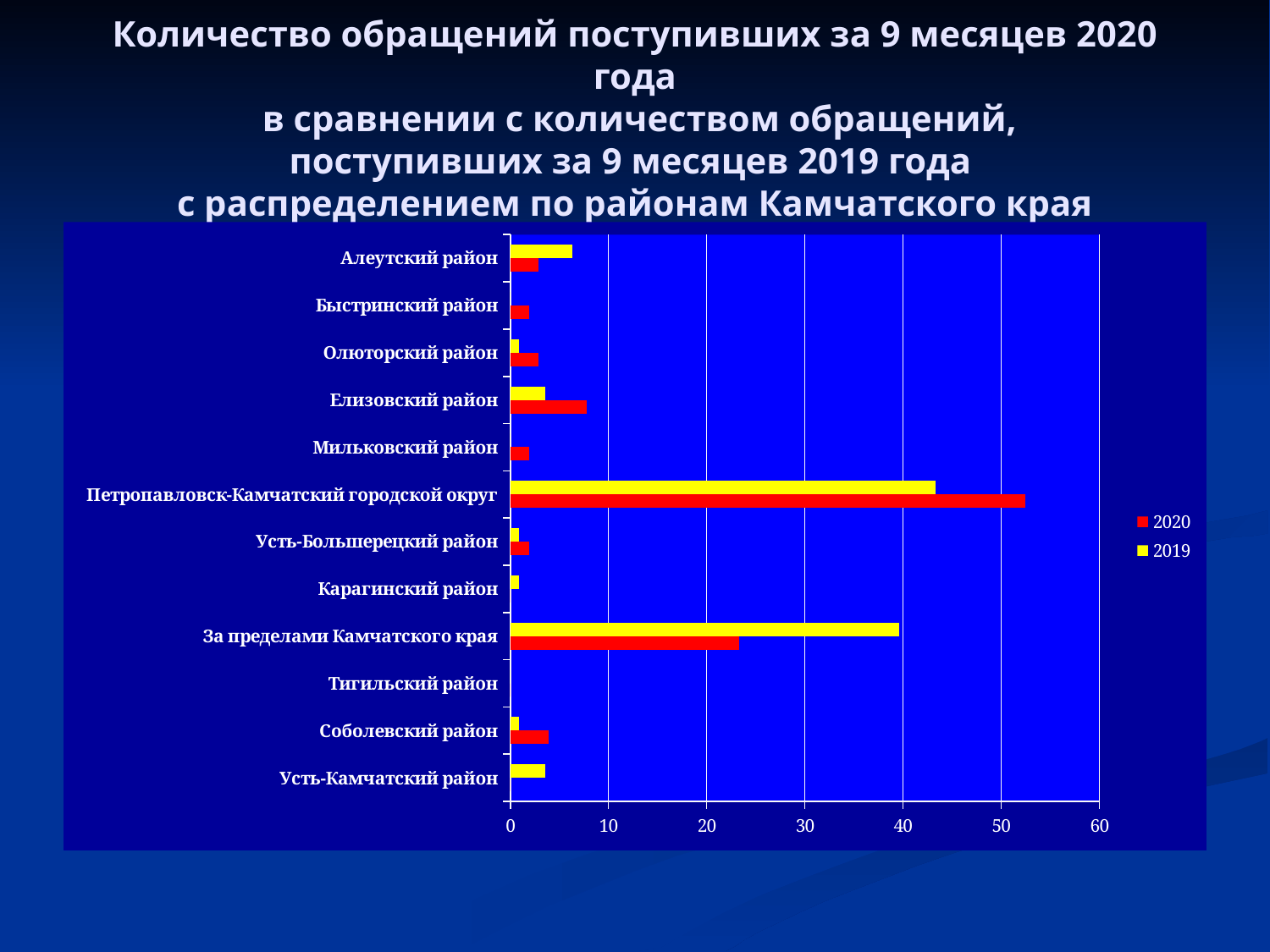
Is the 2020 value for Елизовский район greater or less than 10? less Is the 2019 value for За пределами Камчатского края greater or less than 30? greater Which category has the highest value for 2020? Петропавловск-Камчатский городской округ Which category has the highest value for 2019? Петропавловск-Камчатский городской округ What kind of chart is shown on the slide? bar chart For Петропавловск-Камчатский городской округ, which year has the larger value, 2020 or 2019? 2020 How many series does the legend list? 2 Is the 2020 value for Петропавловск-Камчатский городской округ greater or less than 50? greater How many categories (districts) are shown on the vertical axis? 12 For За пределами Камчатского края, which year has the larger value, 2020 or 2019? 2019 Which category shows no visible bar for either year? Тигильский район Which colour represents the 2019 series in the legend? yellow